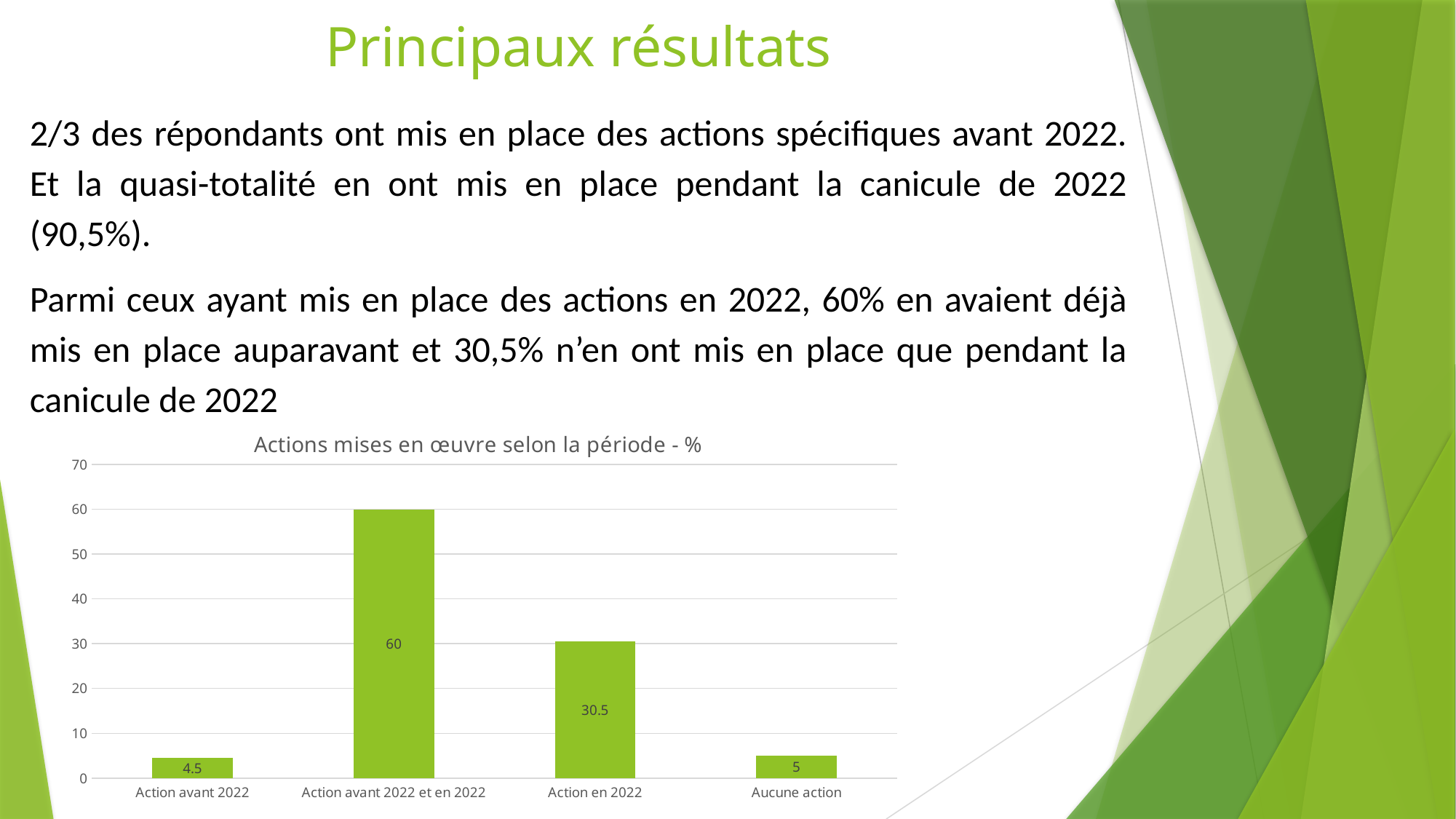
What is the title of the chart? Actions mises en œuvre selon la période - % What kind of chart is shown on the slide? bar chart Which is larger, the value for "Action en 2022" or the value for "Aucune action"? Action en 2022 What is the value for "Action avant 2022 et en 2022"? 60 How many categories are shown on the x axis? 4 What is the value for "Action avant 2022"? 4.5 Is the value for "Action en 2022" greater or less than 40? less What is the value for "Action en 2022"? 30.5 What is the value for "Aucune action"? 5 Which category has the lowest value? Action avant 2022 Which category has the highest value? Action avant 2022 et en 2022 What is the difference between the values for "Action avant 2022 et en 2022" and "Action en 2022"? 29.5